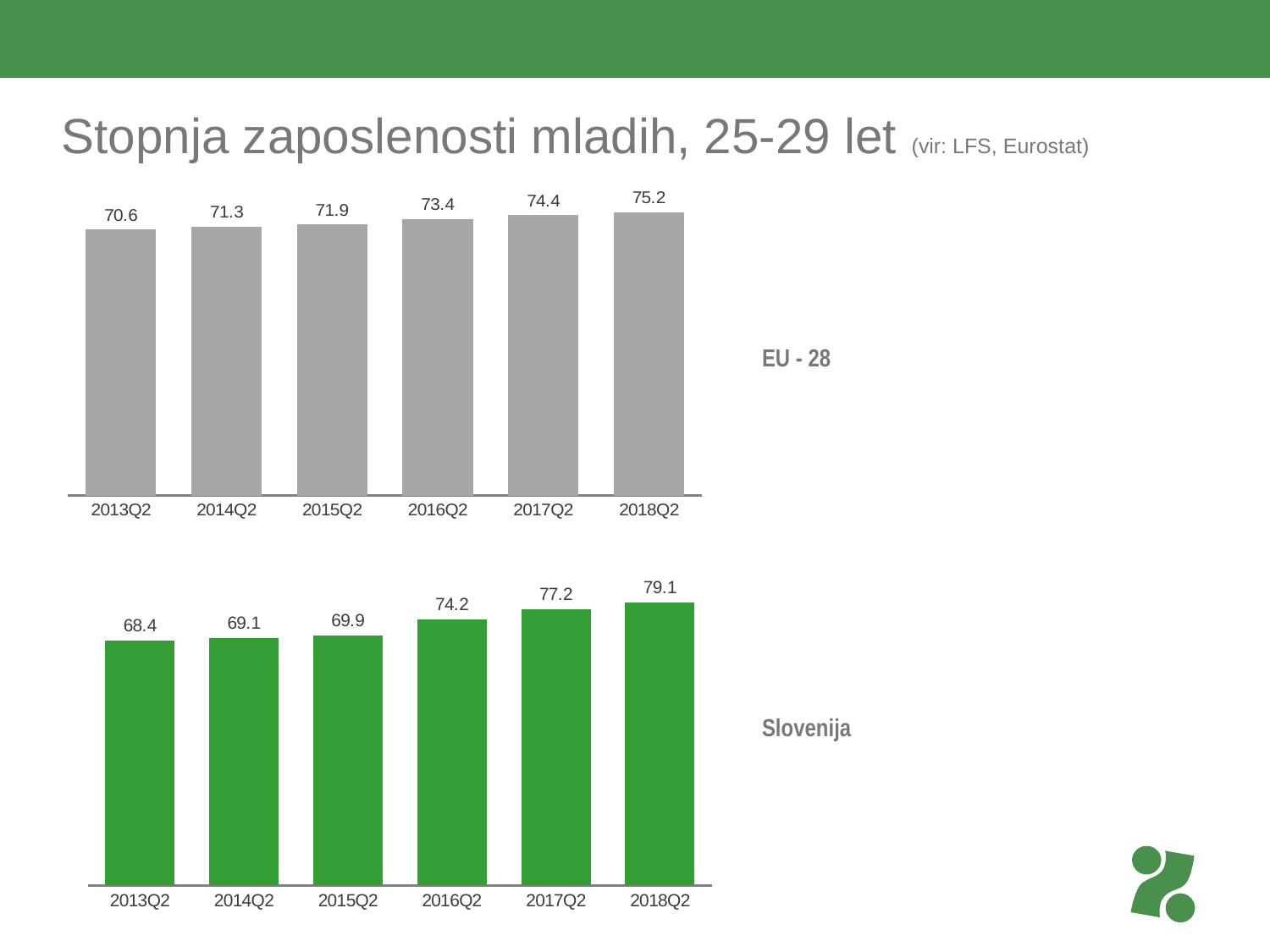
In the Slovenija chart (bottom), is the value for 2015Q2 larger or smaller than the value for 2016Q2? smaller What kind of chart is the Slovenija chart (bottom)? bar chart In the EU - 28 chart (top), do the values rise or fall from 2013Q2 to 2018Q2? rise In the Slovenija chart (bottom), what is the difference between the 2018Q2 and 2013Q2 values? 10.7 Which is larger: the 2018Q2 value in the EU - 28 chart or the 2018Q2 value in the Slovenija chart? Slovenija In the EU - 28 chart (top), what is the difference between the 2018Q2 and 2017Q2 values? 0.8 In the Slovenija chart (bottom), what is the value for 2017Q2? 77.2 In the EU - 28 chart (top), which period has the lowest value? 2013Q2 What colour are the bars in the Slovenija chart (bottom)? green In the Slovenija chart (bottom), which period has the highest value? 2018Q2 How many periods are shown on the x axis of the EU - 28 chart (top)? 6 In the EU - 28 chart (top), what is the value for 2016Q2? 73.4